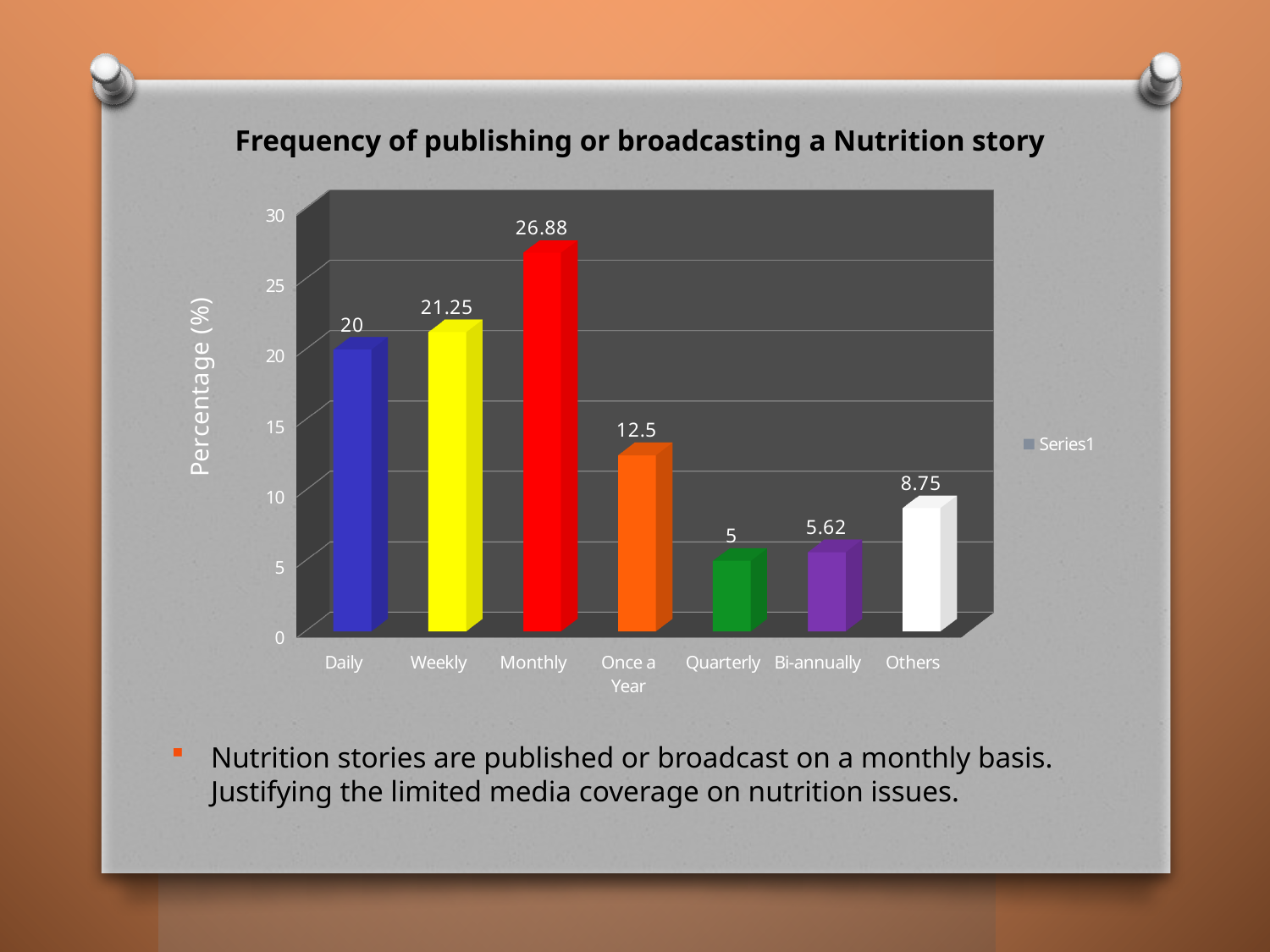
What is the value for Once a Year? 12.5 What is the value for Monthly? 26.88 Which category has the lowest value? Quarterly What is the title of the chart? Frequency of publishing or broadcasting a Nutrition story How many series does the legend list? 1 How many categories are shown on the x axis? 7 What kind of chart is shown? bar chart What is the difference between the values for Weekly and Daily? 1.25 What is the value for Bi-annually? 5.62 Is the value for Once a Year greater or less than 15? less Which is larger, the value for Others or the value for Bi-annually? Others Which category has the highest value? Monthly